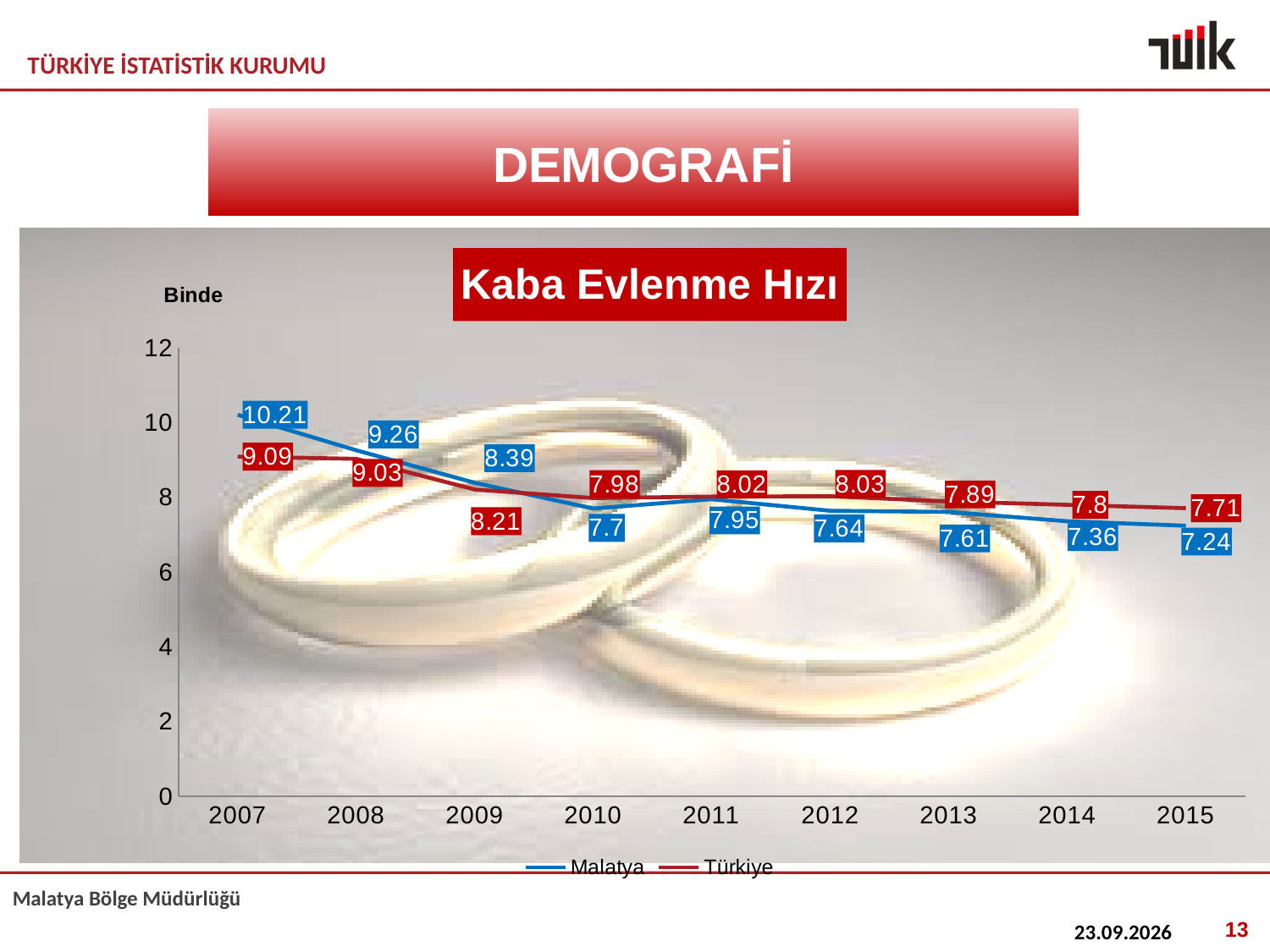
In which year is the Malatya value highest? 2007 What is the Malatya value for 2007? 10.21 What is the Malatya value for 2011? 7.95 In which year is the Malatya value lowest? 2015 How many series does the legend list? 2 What is the Türkiye value for 2015? 7.71 What is the Türkiye value for 2012? 8.03 Which is larger in 2013, the Malatya value or the Türkiye value? Türkiye Does the Türkiye value generally rise or fall from 2007 to 2015? fall What is the difference between the Malatya and Türkiye values in 2007? 1.12 How many years are shown on the x axis? 9 What type of chart is shown on the slide? line chart